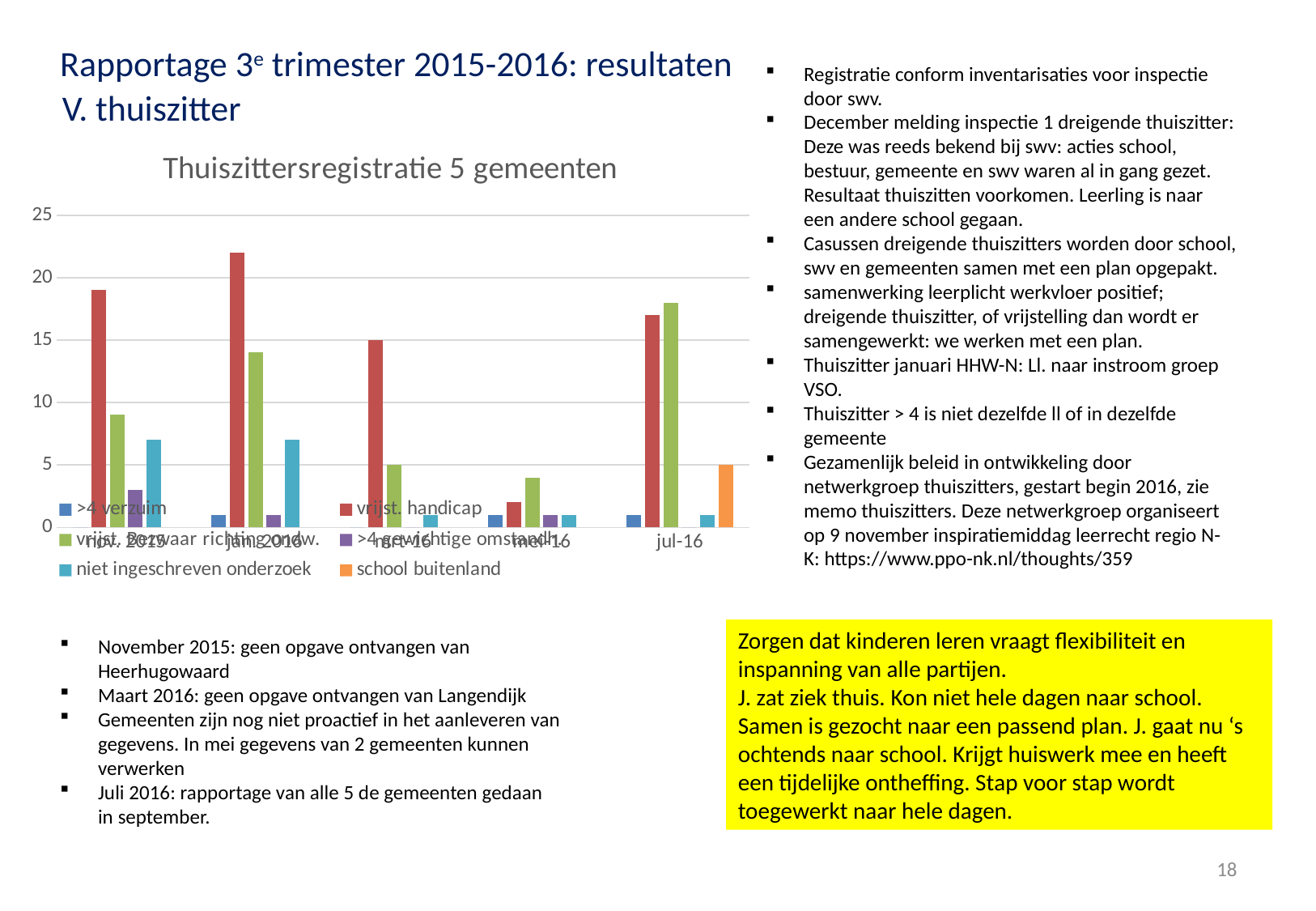
Is the value for 'vrijst. bezwaar richting ondw.' in jan-2016 greater or less than 10? greater In nov-2015, which is larger: 'vrijst. handicap' or 'vrijst. bezwaar richting ondw.'? vrijst. handicap In which category is the 'vrijst. handicap' bar the highest? jan. 2016 Is the value for 'niet ingeschreven onderzoek' in nov-2015 greater or less than 5? greater What is the title of the chart? Thuiszittersregistratie 5 gemeenten Is the value for 'vrijst. handicap' in nov-2015 greater or less than 15? greater In which category is the 'vrijst. handicap' bar the lowest? mei-16 Which series is shown in orange in the chart? school buitenland How many series does the chart legend list? 6 How many categories (time periods) are shown on the x axis of the chart? 5 What type of chart is shown on the slide? bar chart